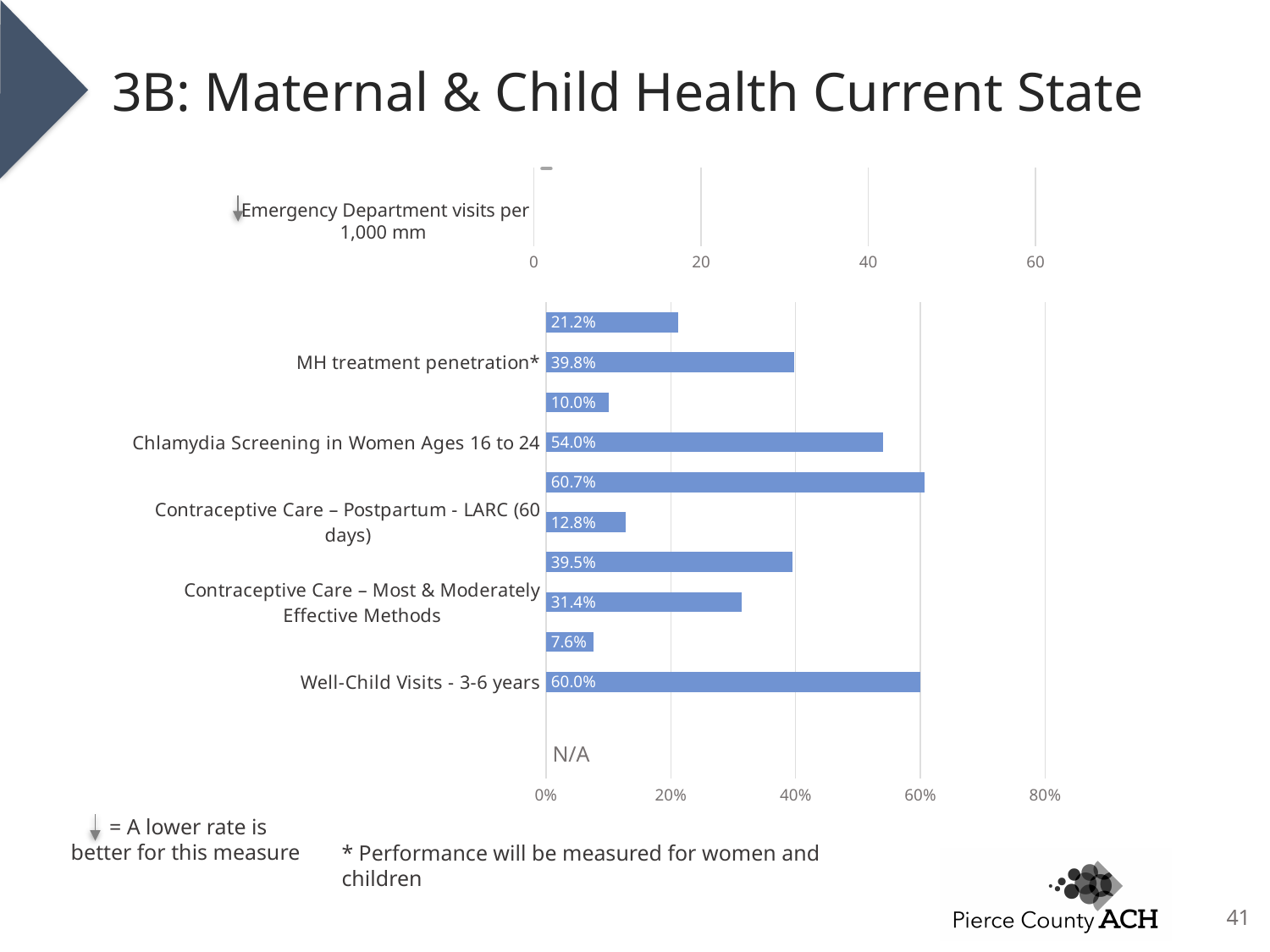
In the lower bar chart, what is the value for Chlamydia Screening in Women Ages 16 to 24? 54.0% In the lower bar chart, which is larger: the value for Chlamydia Screening in Women Ages 16 to 24 or the value for Well-Child Visits - 3-6 years? Well-Child Visits - 3-6 years What kind of chart is the lower chart on the slide? Bar chart What is the category label of the upper chart on the slide? Emergency Department visits per 1,000 mm In the lower bar chart, what is the lowest data label shown on any bar? 7.6% In the lower bar chart, is the value for Chlamydia Screening in Women Ages 16 to 24 greater or less than 40%? greater According to the slide's key, what does the downward arrow next to a measure mean? A lower rate is better for this measure In the lower bar chart, what is the value for Well-Child Visits - 3-6 years? 60.0% In the lower bar chart, what is the difference between the Well-Child Visits - 3-6 years value and the Chlamydia Screening in Women Ages 16 to 24 value? 6.0 percentage points In the lower bar chart, how many bars have a data label printed on them? 10 In the lower bar chart, what is the highest data label shown on any bar? 60.7%